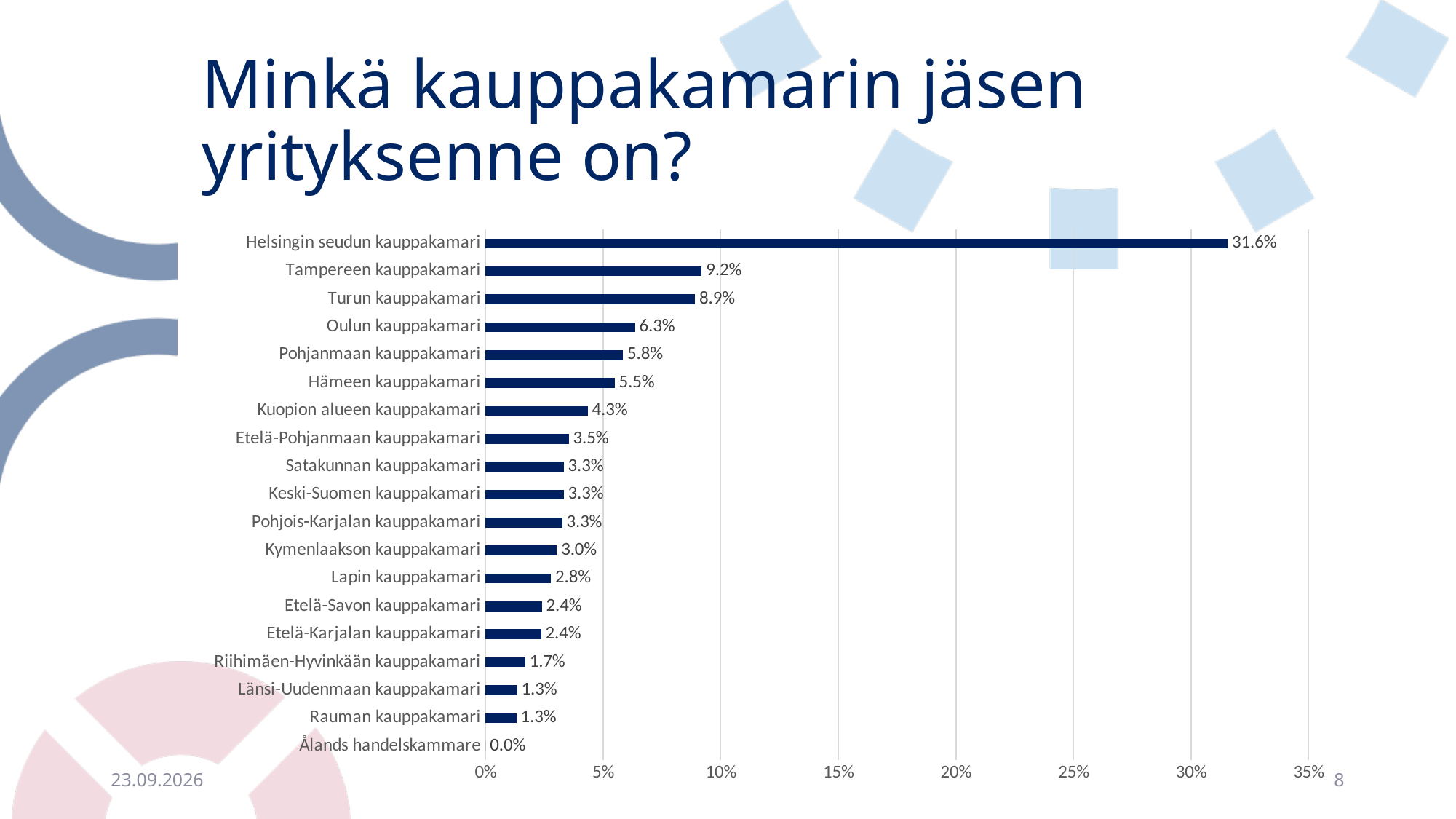
What is the title of the slide? Minkä kauppakamarin jäsen yrityksenne on? How many categories are shown in the chart? 19 Is the value for Helsingin seudun kauppakamari greater or less than 30%? greater Which category has the highest value? Helsingin seudun kauppakamari What is the difference between the values for Tampereen kauppakamari and Turun kauppakamari? 0.3% What is the value for Oulun kauppakamari? 6.3% What is the value for Helsingin seudun kauppakamari? 31.6% What is the value for Riihimäen-Hyvinkään kauppakamari? 1.7% What kind of chart is shown on the slide? Bar chart Which is larger, the value for Pohjanmaan kauppakamari or Hämeen kauppakamari? Pohjanmaan kauppakamari Which category has the lowest value? Ålands handelskammare What is the difference between the values for Helsingin seudun kauppakamari and Tampereen kauppakamari? 22.4%